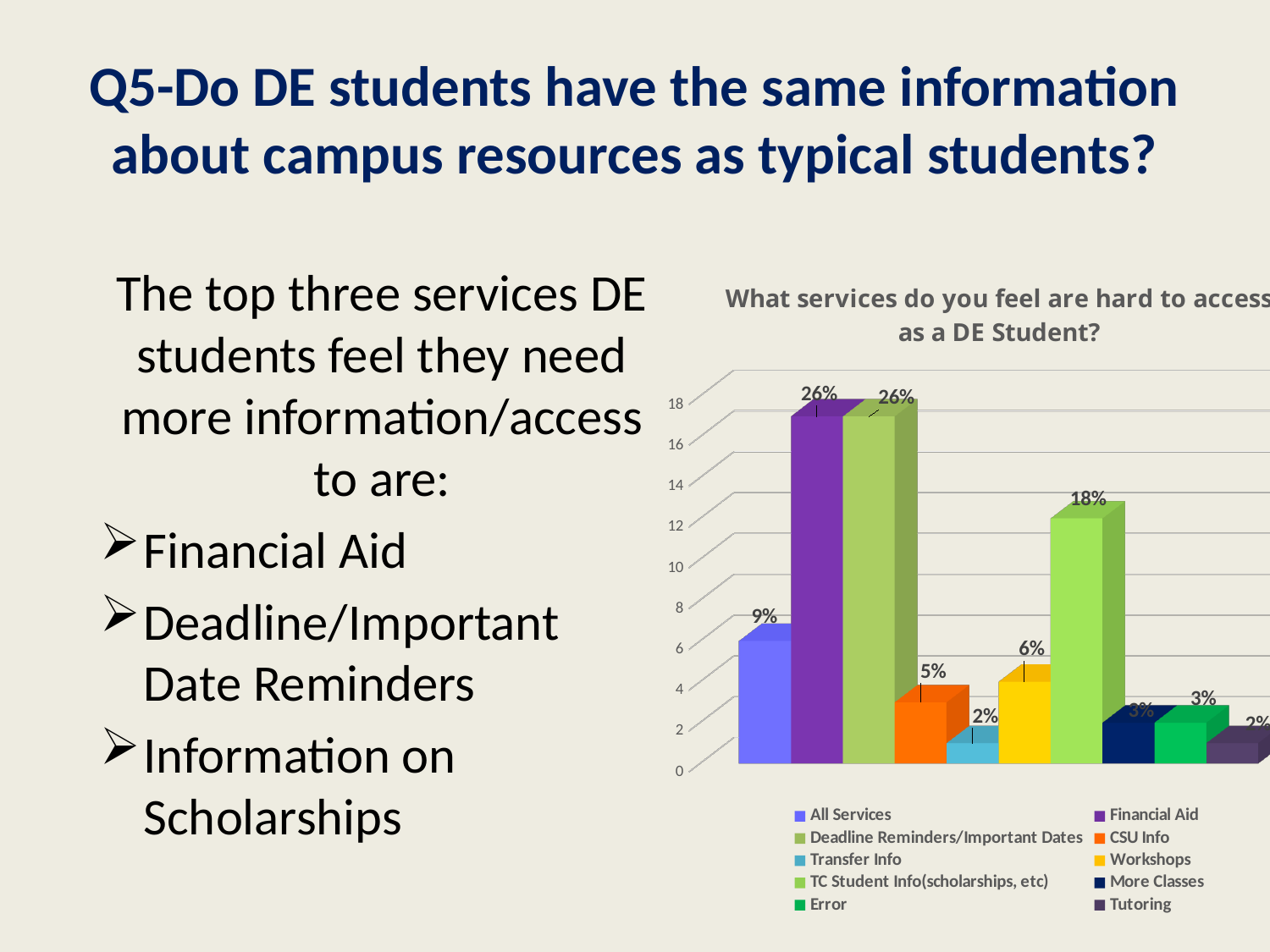
What is the data label for CSU Info? 5% What percentage is shown for Workshops? 6% What is the value shown for Transfer Info? 2% What is the data label for Financial Aid in the chart? 26% How many series does the legend list? 10 What is the title of the chart? What services do you feel are hard to access as a DE Student? What is the difference in percentage points between Financial Aid and TC Student Info(scholarships, etc)? 8 Which has a larger value, All Services or TC Student Info(scholarships, etc)? TC Student Info(scholarships, etc) Which has a larger value, Workshops or CSU Info? Workshops What is the value shown for All Services? 9% What percentage is shown for TC Student Info(scholarships, etc)? 18% What kind of chart is shown on the slide? Bar chart